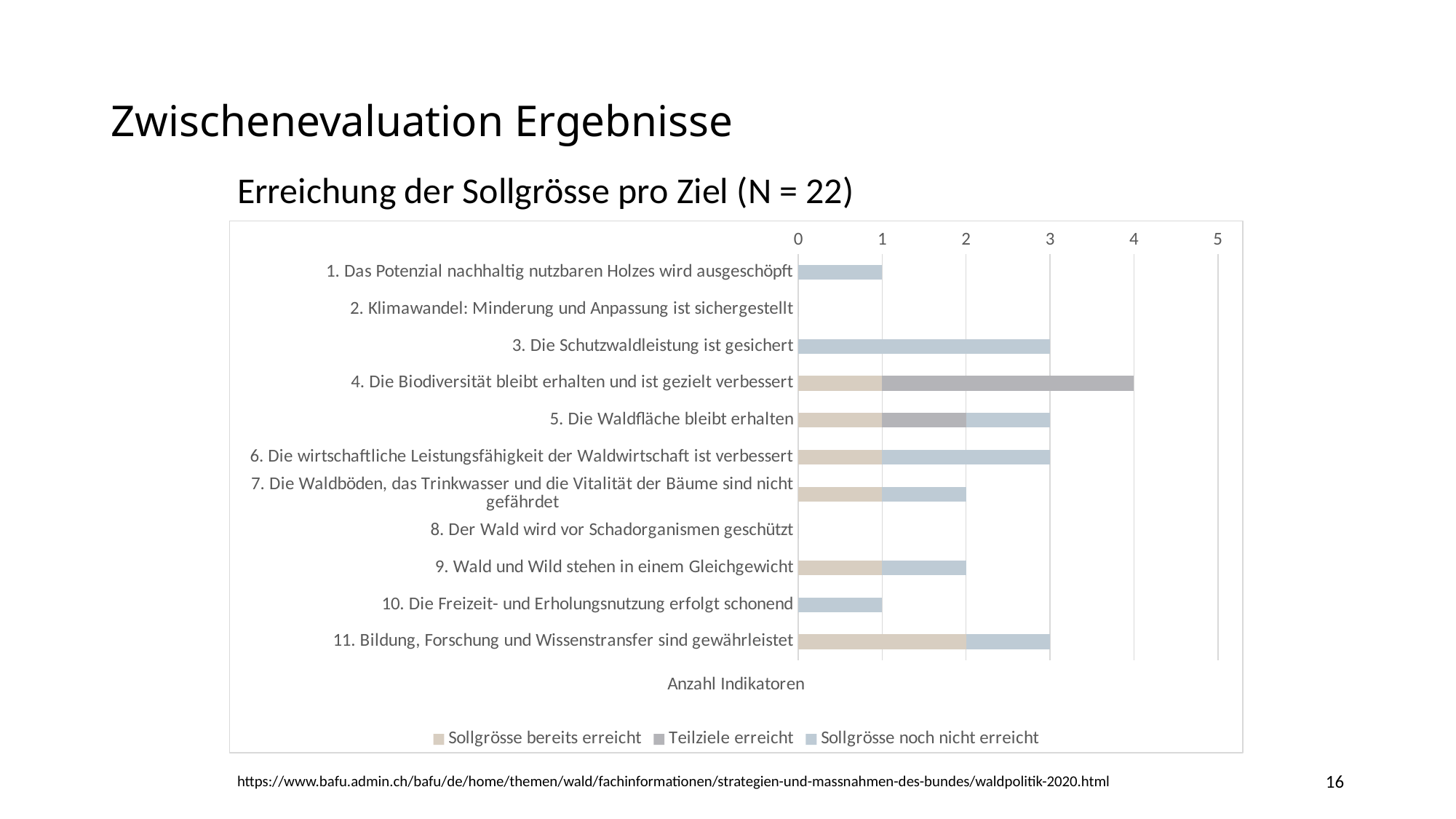
What is the difference between the total number of indicators for goal 4 (Biodiversität) and goal 7 (Waldböden, Trinkwasser und Vitalität der Bäume)? 2 How many series does the legend list? 3 What is the title of the chart? Erreichung der Sollgrösse pro Ziel (N = 22) What kind of chart is shown on the slide? Stacked bar chart How many goals (categories) are listed on the vertical axis of the chart? 11 Which has more total indicators: goal 6 (Die wirtschaftliche Leistungsfähigkeit der Waldwirtschaft ist verbessert) or goal 10 (Die Freizeit- und Erholungsnutzung erfolgt schonend)? Goal 6 What is the total number of indicators for goal 4 (Die Biodiversität bleibt erhalten und ist gezielt verbessert)? 4 How many indicators for goal 4 (Die Biodiversität bleibt erhalten und ist gezielt verbessert) fall under 'Teilziele erreicht'? 3 What is the total number of indicators for goal 5 (Die Waldfläche bleibt erhalten)? 3 Which goal has the highest total number of indicators? 4. Die Biodiversität bleibt erhalten und ist gezielt verbessert How many indicators for goal 3 (Die Schutzwaldleistung ist gesichert) fall under 'Sollgrösse noch nicht erreicht'? 3 How many indicators for goal 11 (Bildung, Forschung und Wissenstransfer sind gewährleistet) fall under 'Sollgrösse bereits erreicht'? 2